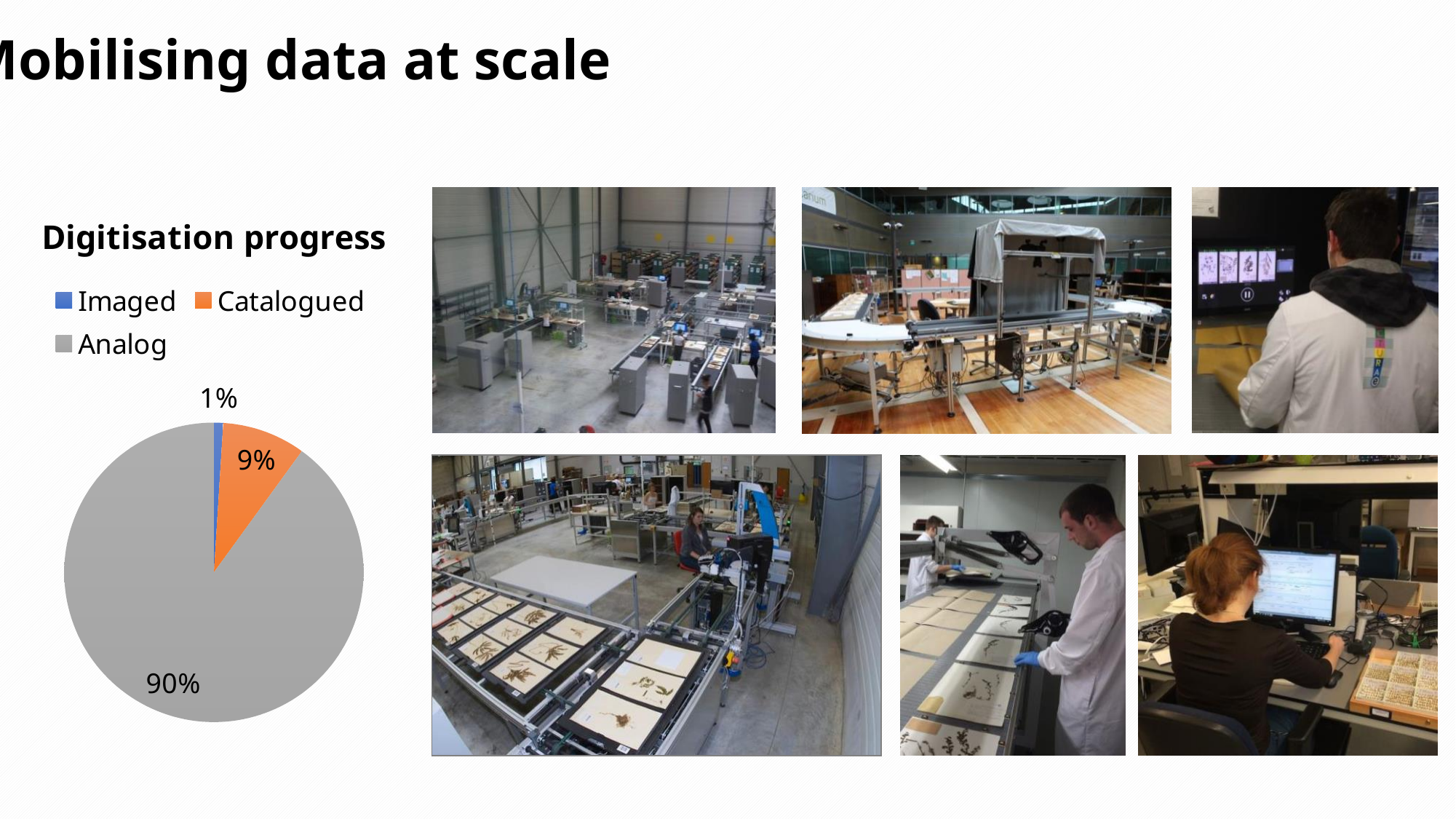
What kind of chart is shown under the title "Digitisation progress"? pie chart How many categories does the legend list? 3 Which category has the largest slice of the pie? Analog Which category has the smallest slice of the pie? Imaged Which is larger, the Catalogued slice or the Imaged slice? Catalogued What percentage of the pie is labelled Imaged? 1% What colour is the Catalogued slice in the pie chart? orange What is the title of the chart? Digitisation progress What is the difference in percentage points between the Analog and Catalogued slices? 81 What is the combined share of the Imaged and Catalogued slices? 10% What percentage of the pie is labelled Analog? 90% What percentage of the pie is labelled Catalogued? 9%